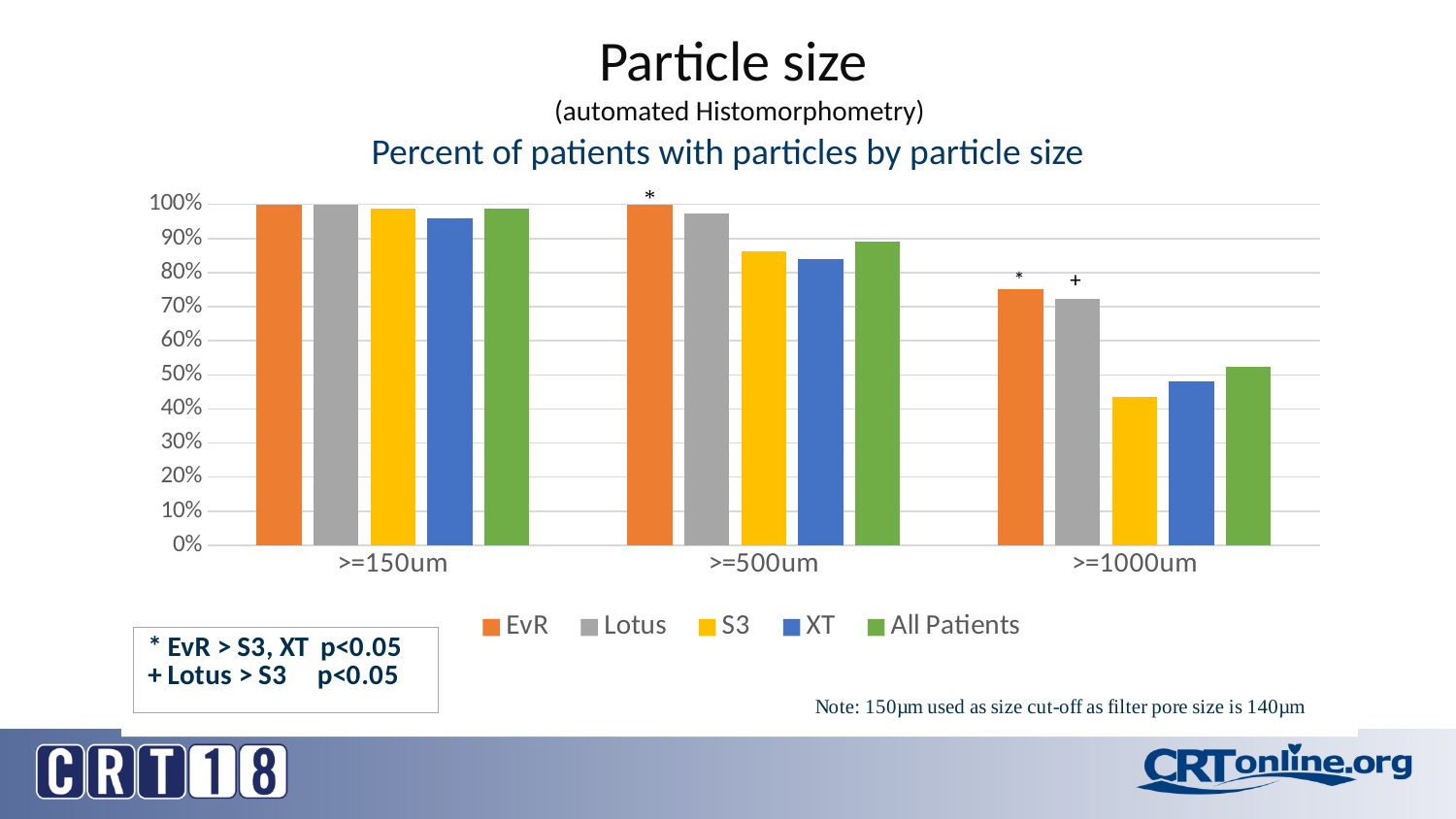
Is the value for S3 in the >=500um category greater or less than 90%? less Which series is shown in orange in the legend? EvR What is the value for EvR in the >=150um category? 100% Do the values for All Patients rise or fall as the particle size category increases along the x axis? fall Is the value for S3 in the >=1000um category greater or less than 50%? less In the >=1000um category, which is larger, the value for XT or the value for S3? XT Is the value for All Patients in the >=1000um category greater or less than 50%? greater How many particle size categories are shown on the x axis? 3 How many series does the legend list? 5 Which series has the lowest value in the >=1000um category? S3 What kind of chart is shown on the slide? bar chart